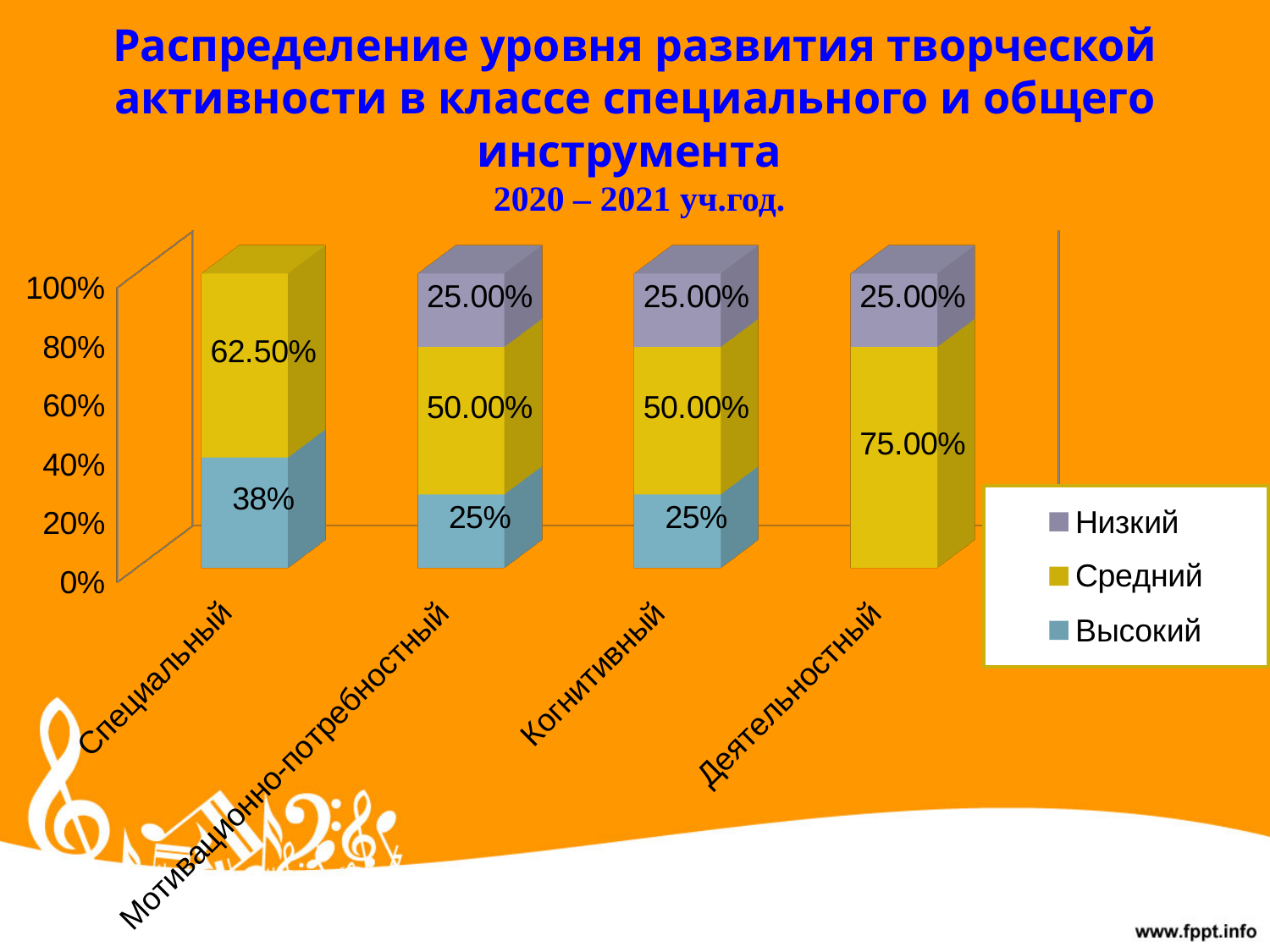
What is the value of the Средний series for the Специальный category? 62.50% What kind of chart is shown on the slide? stacked bar chart What is the value of the Средний series for the Деятельностный category? 75.00% What is the value of the Низкий series for the Когнитивный category? 25.00% Which legend entry is shown in yellow? Средний Which category has the highest value for the Средний series? Деятельностный What is the value of the Высокий series for the Специальный category? 38% What is the value of the Высокий series for the Мотивационно-потребностный category? 25% How many series does the chart legend list? 3 How many categories are shown along the x axis of the chart? 4 Which category has the highest value for the Высокий series? Специальный What is the difference between the Средний value for Деятельностный and the Средний value for Когнитивный? 25.00%